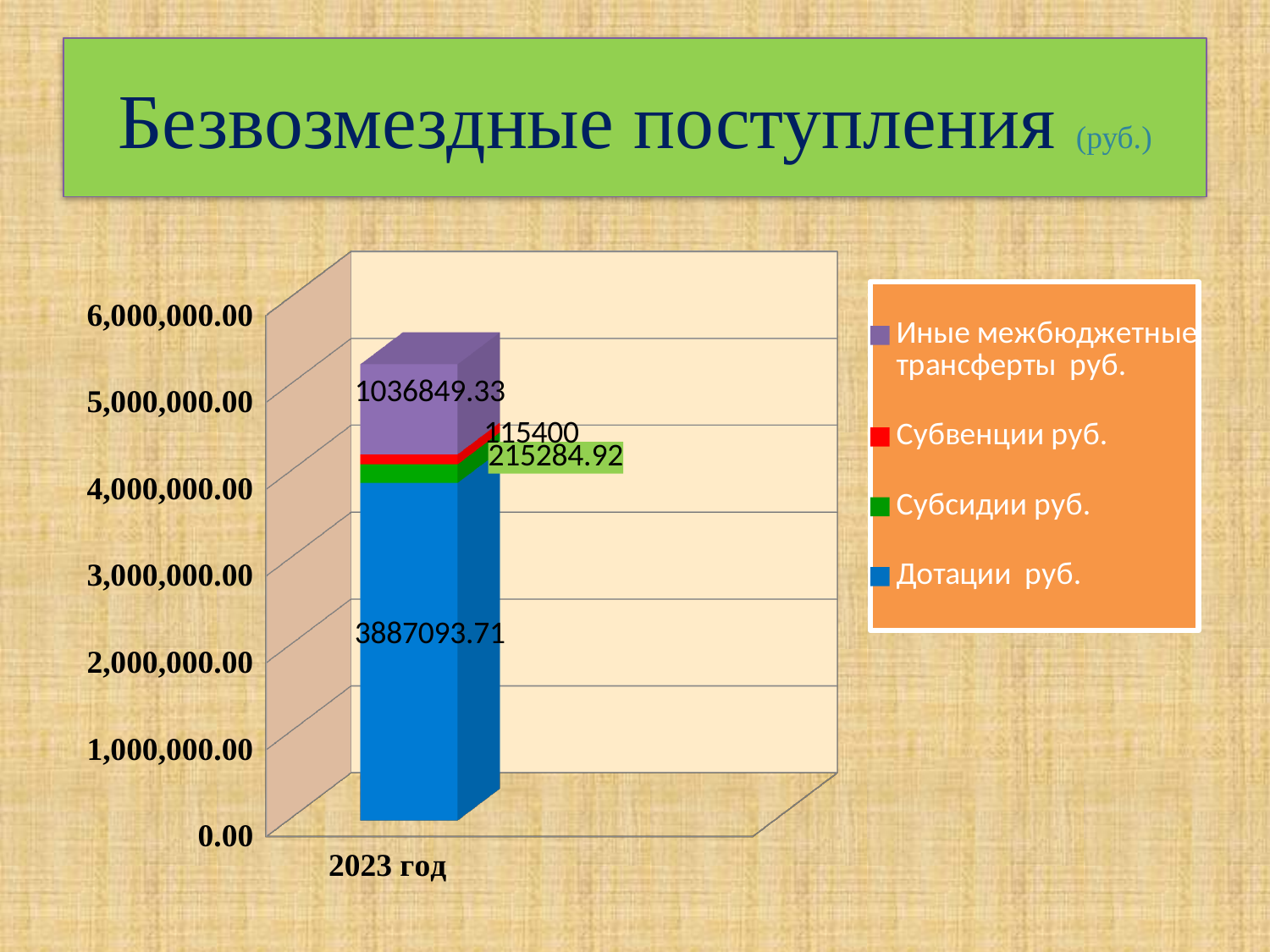
What is the value of Субвенции руб. for 2023 год? 115400 How many series does the legend list? 4 Which is larger for 2023 год: Субсидии руб. or Субвенции руб.? Субсидии руб. What is the difference between Субсидии руб. and Субвенции руб. for 2023 год? 99884.92 What is the value of Субсидии руб. for 2023 год? 215284.92 What type of chart is shown on the slide? Stacked bar chart Which series has the smallest value in the 2023 год bar? Субвенции руб. What is the difference between Дотации руб. and Иные межбюджетные трансферты руб. for 2023 год? 2850244.38 What is the value of Иные межбюджетные трансферты руб. for 2023 год? 1036849.33 What is the value of Дотации руб. for 2023 год? 3887093.71 Which series has the largest value in the 2023 год bar? Дотации руб. What is the total of the stacked bar for 2023 год? 5254627.96